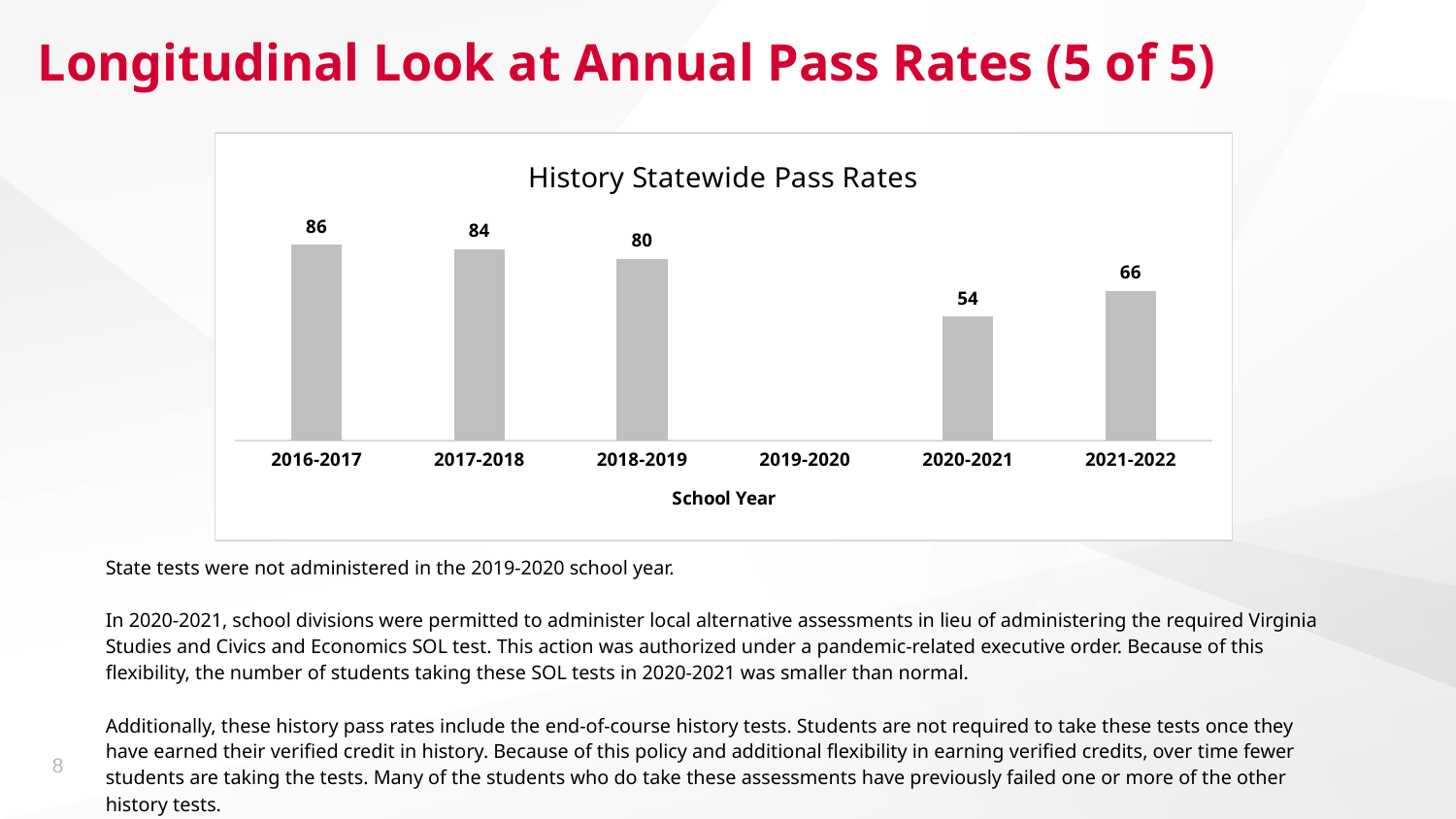
What is the History statewide pass rate for 2016-2017? 86 What is the History statewide pass rate for 2020-2021? 54 How many school years are labeled on the x axis of the chart? 6 What is the title of the chart? History Statewide Pass Rates What is the History statewide pass rate for 2021-2022? 66 What is the difference between the pass rates for 2021-2022 and 2020-2021? 12 Which school year has the highest History statewide pass rate? 2016-2017 Do the pass rates rise or fall from 2016-2017 to 2018-2019? Fall Which is larger, the pass rate for 2017-2018 or for 2018-2019? 2017-2018 What kind of chart is shown on the slide? Bar chart Which school year with a plotted bar has the lowest History statewide pass rate? 2020-2021 What is the difference between the pass rates for 2016-2017 and 2020-2021? 32